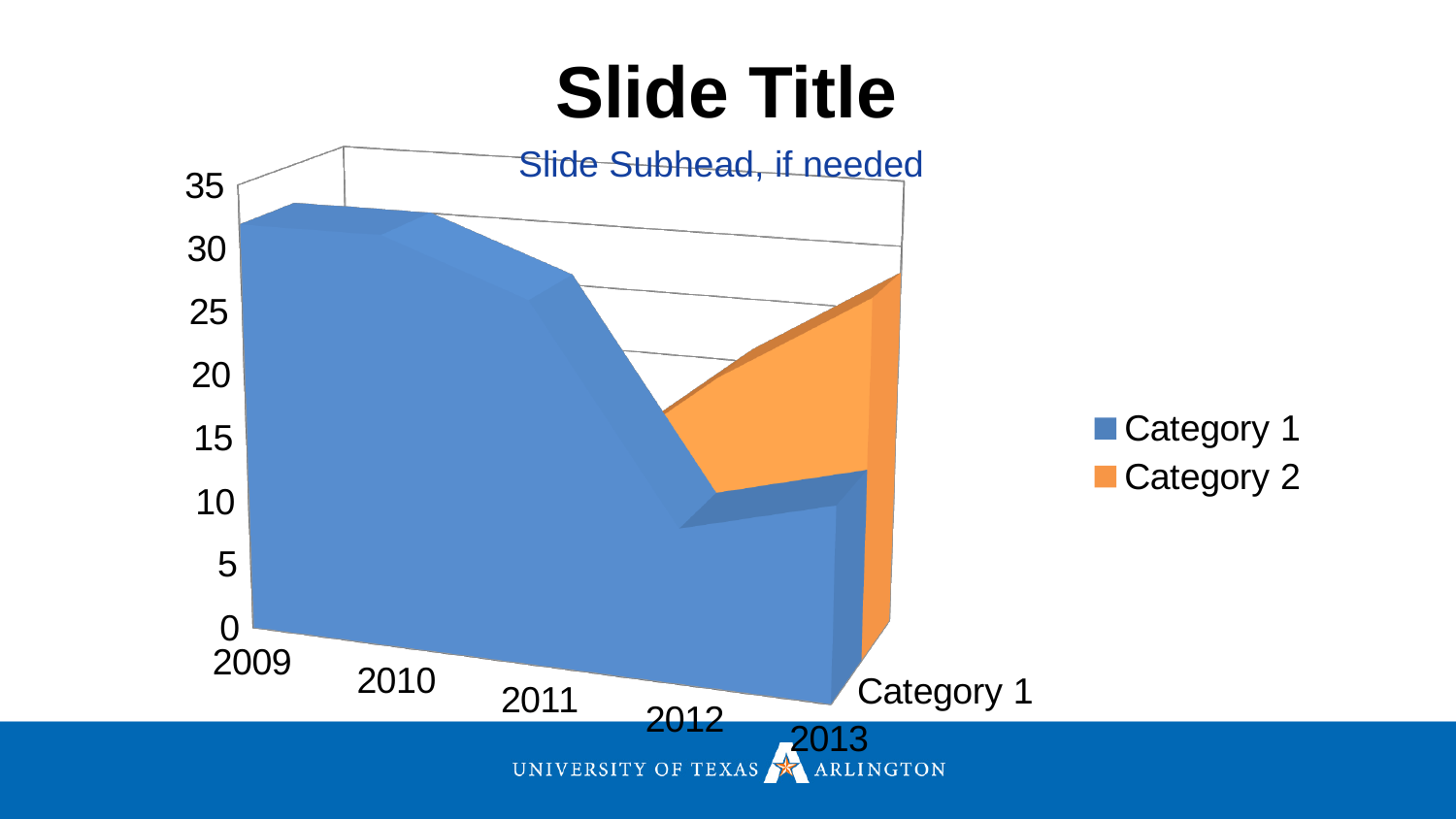
What are the two series named in the legend? Category 1 and Category 2 Does the value for Category 1 rise or fall from 2009 to 2012? fall How many years are shown along the x axis? 5 Is the value for Category 1 in 2012 greater or less than 15? less Is the value for Category 1 in 2013 greater or less than 20? less Is the value for Category 2 in 2013 greater or less than 20? greater What kind of chart is shown on the slide? area chart Which is larger for Category 1, the value in 2011 or the value in 2012? 2011 How many series does the legend list? 2 Which colour represents Category 2? orange In which year is the value for Category 1 lowest? 2012